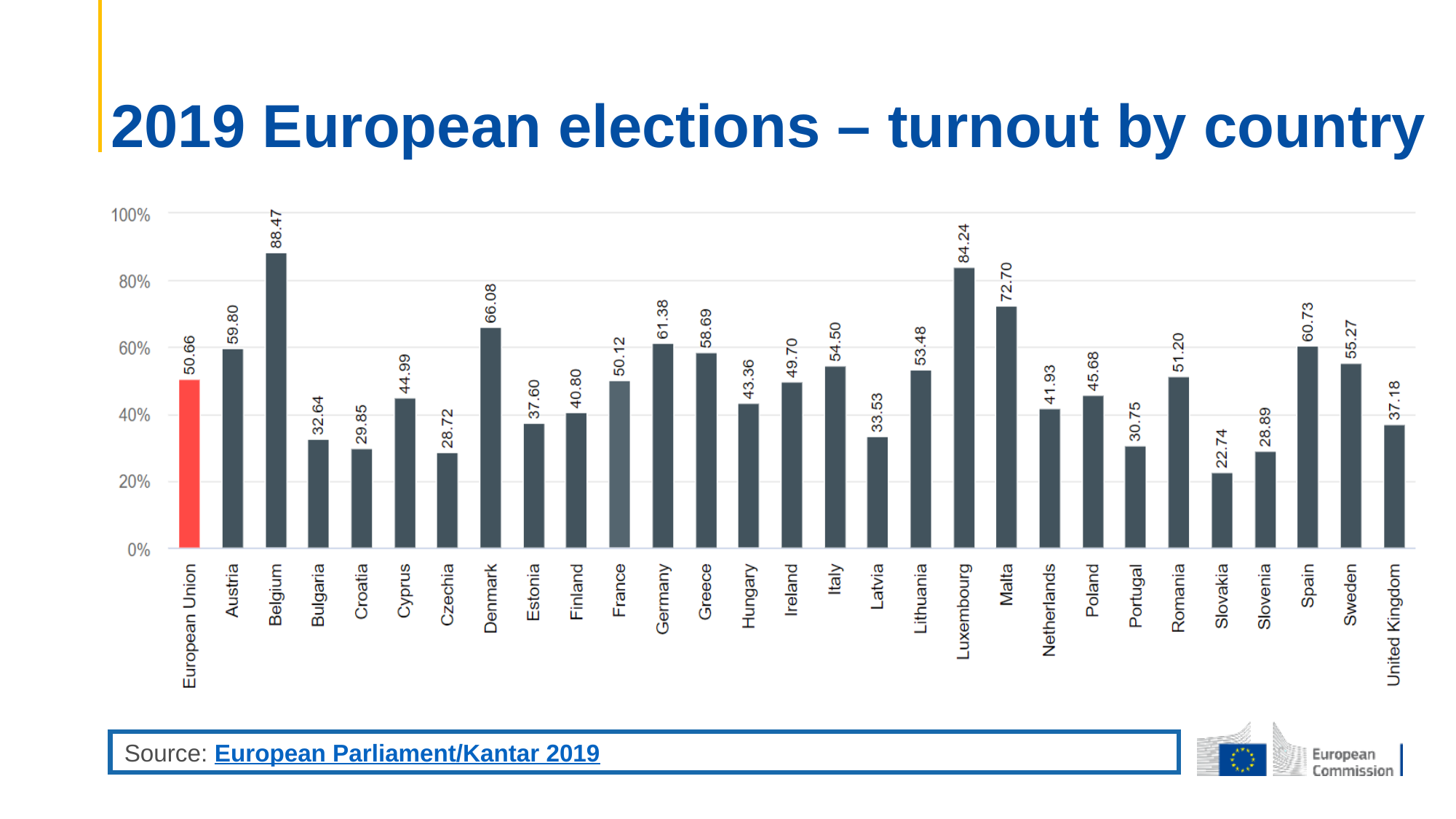
What kind of chart is shown on the slide? Bar chart How many bars are plotted in the chart? 29 What is the turnout value shown for Slovakia? 22.74 What is the difference between the turnout values for Germany and France? 11.26 Is the turnout value for Portugal greater or less than 40%? less What is the turnout value shown for the European Union bar? 50.66 What is the turnout value shown for Belgium? 88.47 Which country has the lowest turnout in the chart? Slovakia Which bar is highlighted in red in the chart? European Union What is the difference between the turnout values for Belgium and Luxembourg? 4.23 Which country has the highest turnout in the chart? Belgium Which has a higher turnout, Malta or Denmark? Malta